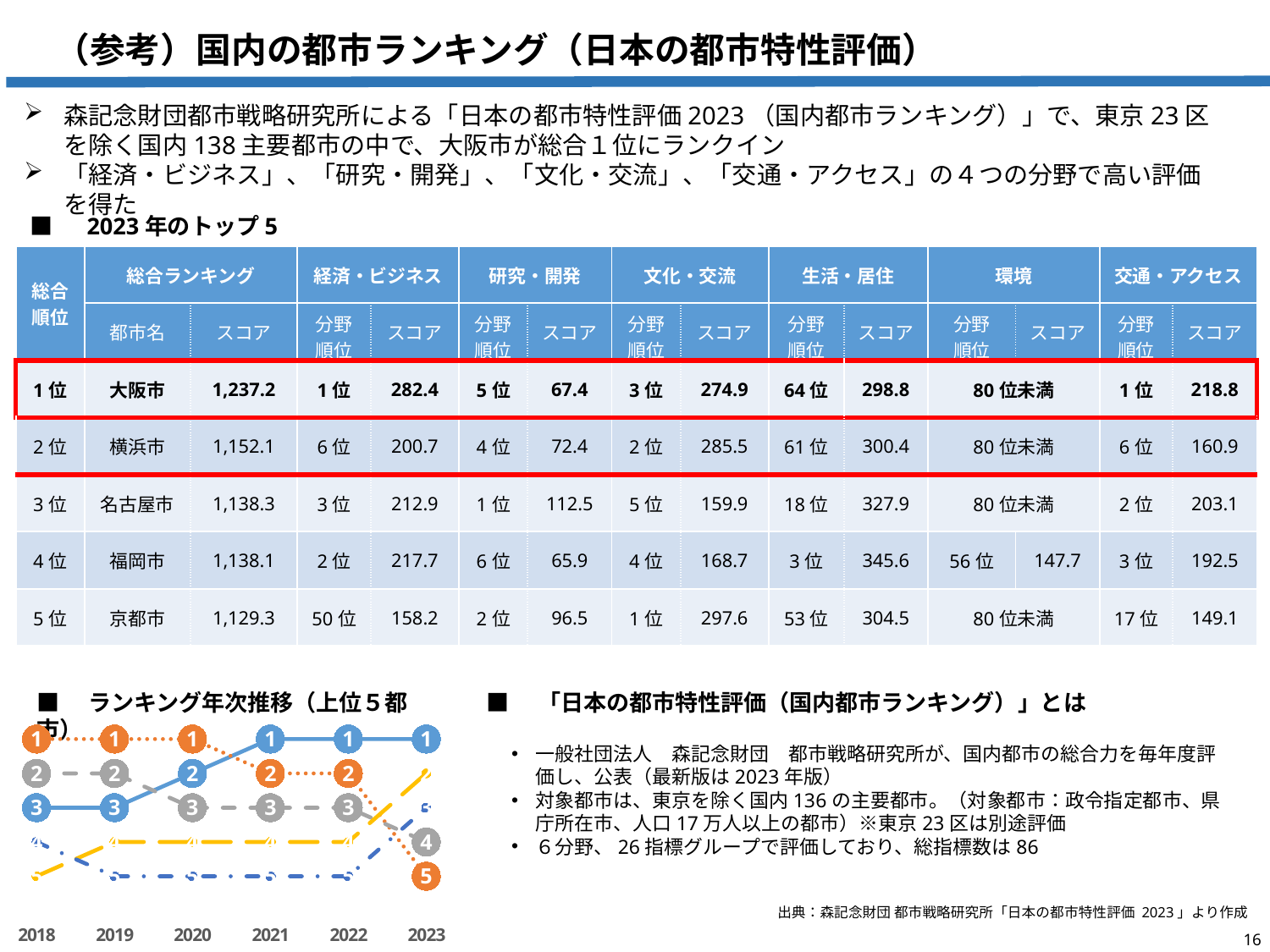
In the 「ランキング年次推移（上位5都市）」 chart, how many years are shown on the x axis? 6 In the 「ランキング年次推移（上位5都市）」 chart, what is the lowest rank number labelled for 2023? 5 In the 「ランキング年次推移（上位5都市）」 chart, what is the first year shown on the x axis? 2018 In the 「ランキング年次推移（上位5都市）」 chart, what is the last year shown on the x axis? 2023 What kind of chart is shown at the bottom left of the slide under 「ランキング年次推移（上位5都市）」? line chart What is the title of the line chart at the bottom left of the slide? ランキング年次推移（上位5都市） In the 「ランキング年次推移（上位5都市）」 chart, what is the highest rank number labelled for 2023? 1